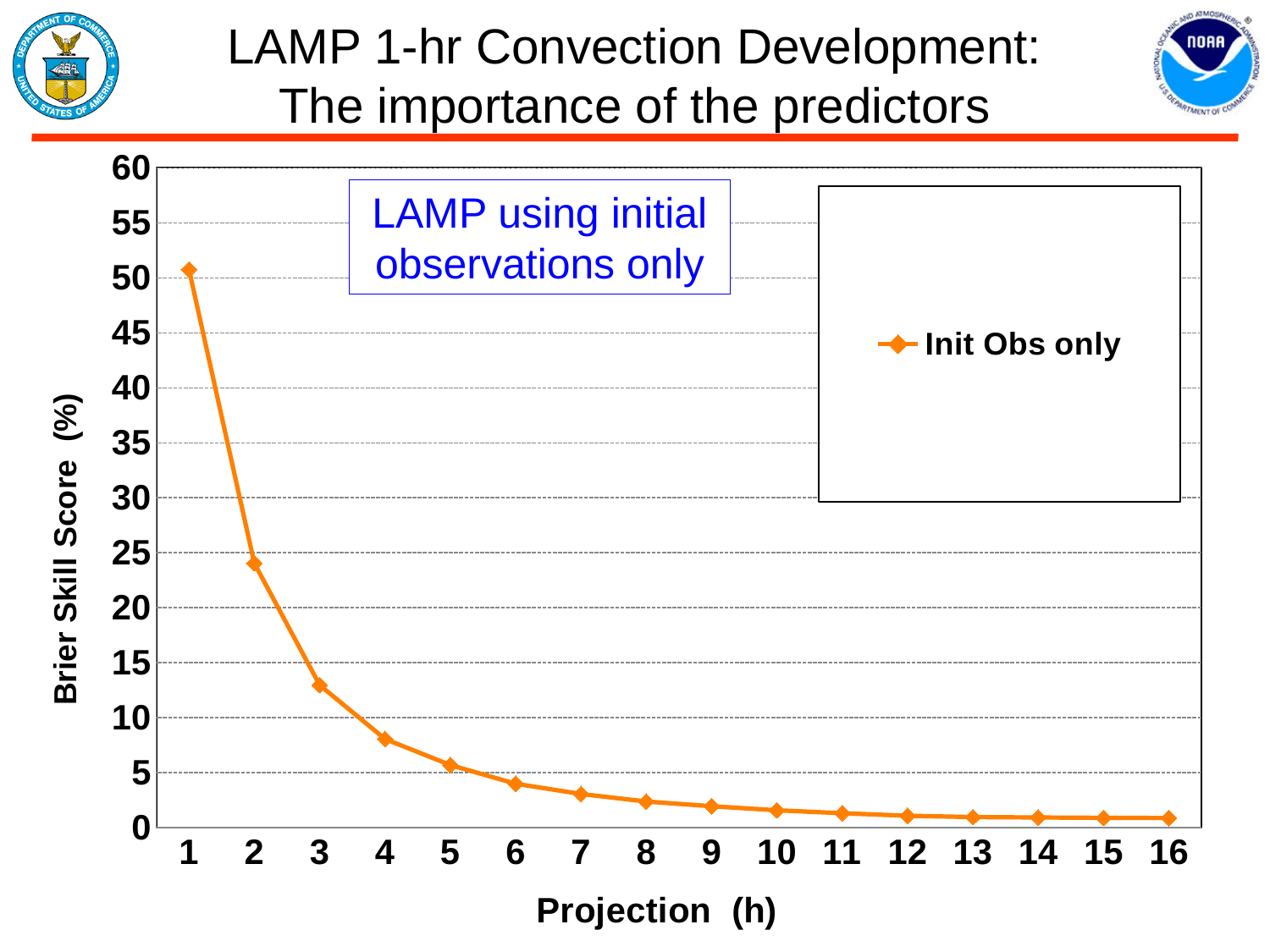
What kind of chart is shown on the slide? line chart Does the Brier Skill Score rise or fall as the projection hour increases? fall What is the label of the y axis? Brier Skill Score (%) Is the Brier Skill Score at projection 1 h greater or less than 50? greater Which has the larger Brier Skill Score, projection 2 h or projection 4 h? 2 h At which projection hour is the Brier Skill Score highest? 1 Is the Brier Skill Score at projection 2 h greater or less than 30? less What is the name of the series shown in the legend? Init Obs only How many series does the legend list? 1 How many projection hours are plotted along the x axis? 16 Is the Brier Skill Score at projection 3 h greater or less than 10? greater